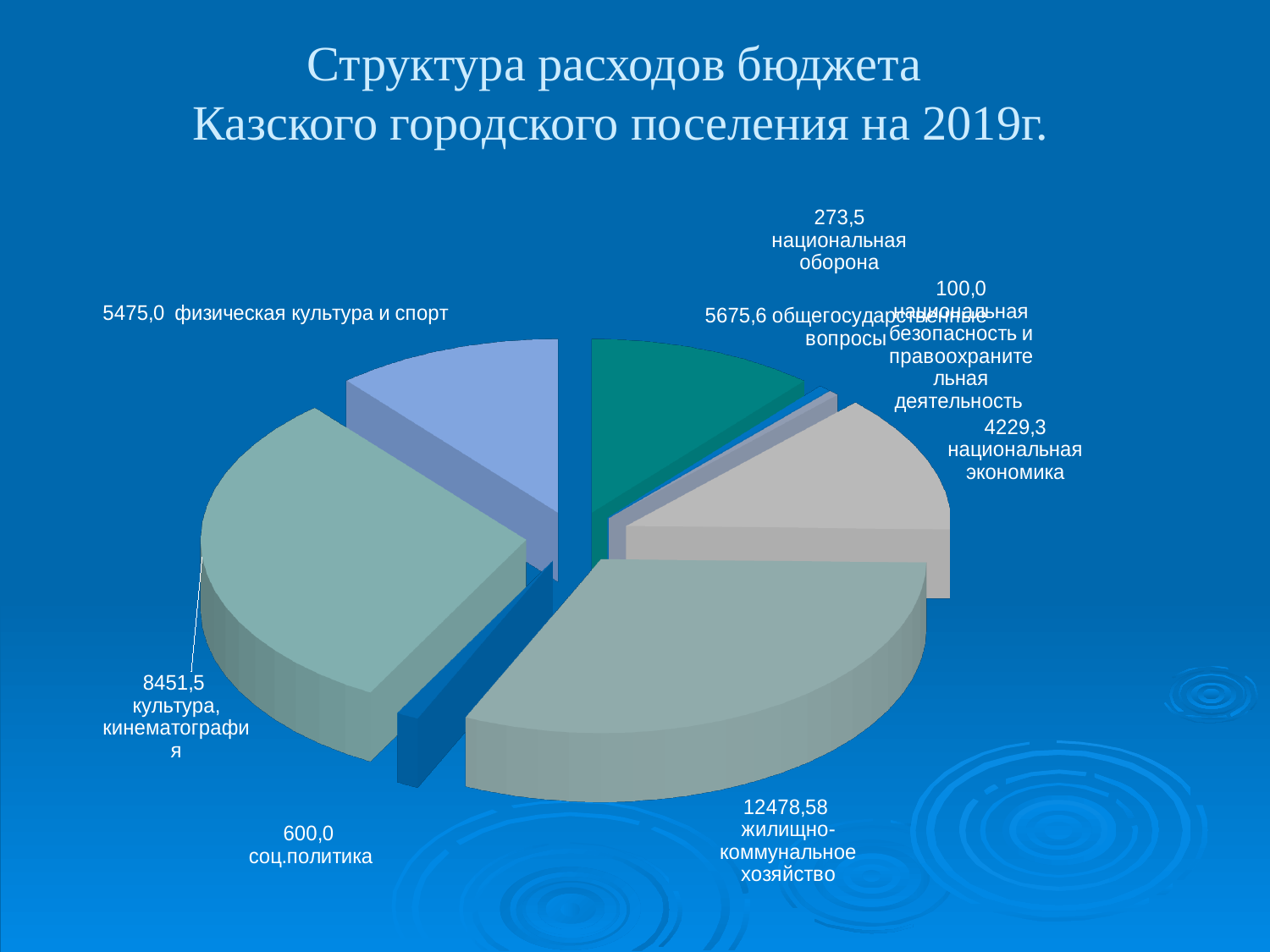
What is the title of the slide? Структура расходов бюджета Казского городского поселения на 2019г. Which category has the smallest value? национальная безопасность и правоохранительная деятельность What is the value for жилищно-коммунальное хозяйство? 12478,58 What is the difference between общегосударственные вопросы and физическая культура и спорт? 200,6 How many categories does the pie chart have? 8 What is the value for национальная оборона? 273,5 What kind of chart is shown on the slide? pie chart What is the value for культура, кинематография? 8451,5 Which category has the largest value? жилищно-коммунальное хозяйство What is the value for соц.политика? 600,0 What is the value for национальная экономика? 4229,3 Which is larger: физическая культура и спорт or общегосударственные вопросы? общегосударственные вопросы